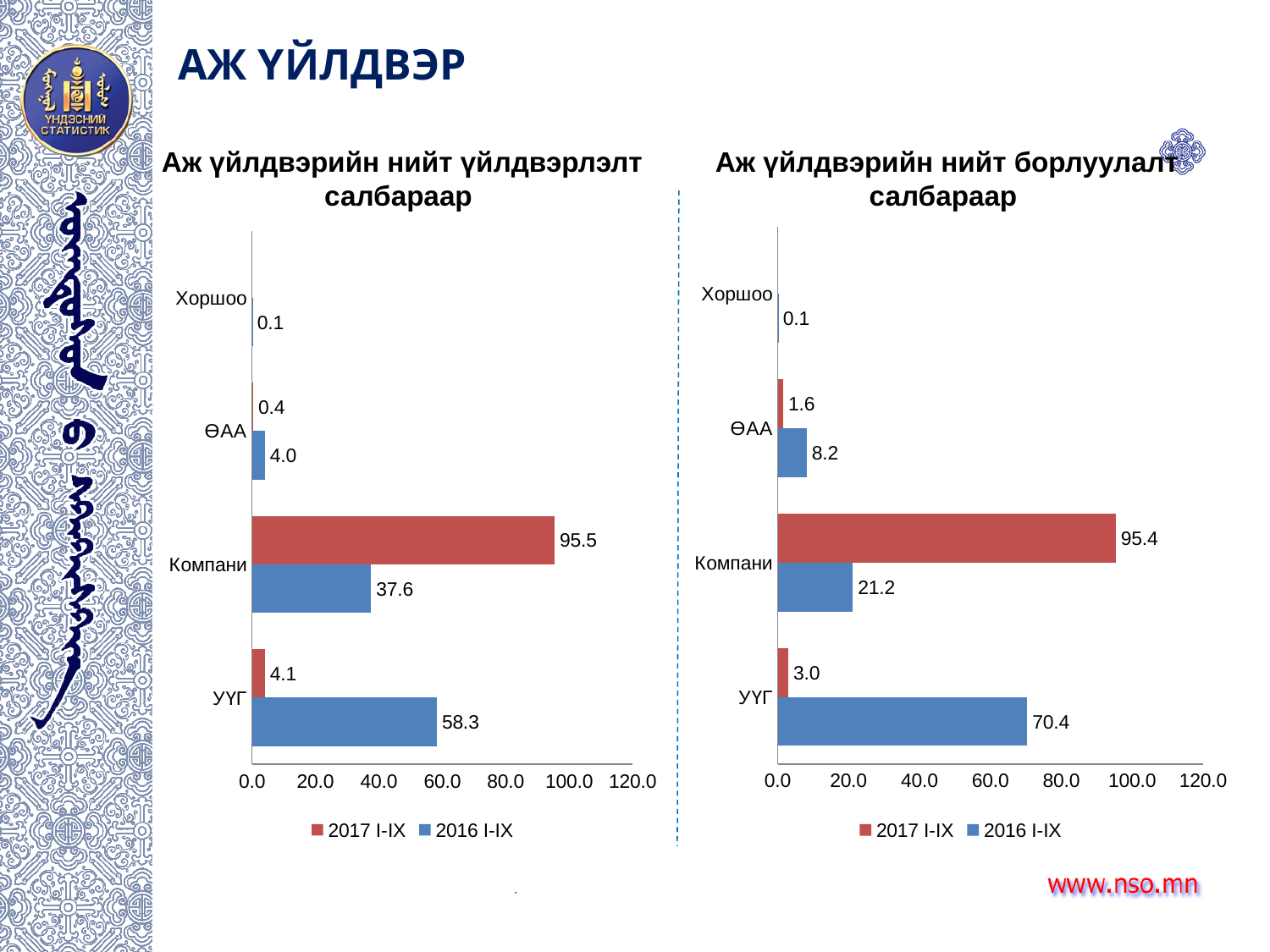
In the left chart (Аж үйлдвэрийн нийт үйлдвэрлэлт салбараар), which category has the highest value for 2016 I-IX? УҮГ How many series does the legend of the left chart (Аж үйлдвэрийн нийт үйлдвэрлэлт салбараар) list? 2 In the right chart (Аж үйлдвэрийн нийт борлуулалт салбараар), what is the value for Компани in 2017 I-IX? 95.4 In the left chart (Аж үйлдвэрийн нийт үйлдвэрлэлт салбараар), what is the value for УҮГ in 2016 I-IX? 58.3 In the right chart (Аж үйлдвэрийн нийт борлуулалт салбараар), which is larger for УҮГ: the 2017 I-IX value or the 2016 I-IX value? 2016 I-IX In the right chart (Аж үйлдвэрийн нийт борлуулалт салбараар), what is the value for ӨАА in 2017 I-IX? 1.6 In the left chart (Аж үйлдвэрийн нийт үйлдвэрлэлт салбараар), what is the value for ӨАА in 2016 I-IX? 4.0 In the left chart (Аж үйлдвэрийн нийт үйлдвэрлэлт салбараар), what is the difference between the 2017 I-IX and 2016 I-IX values for Компани? 57.9 In the right chart (Аж үйлдвэрийн нийт борлуулалт салбараар), what is the difference between the 2016 I-IX and 2017 I-IX values for УҮГ? 67.4 What type of chart is the right chart (Аж үйлдвэрийн нийт борлуулалт салбараар)? Bar chart In the left chart (Аж үйлдвэрийн нийт үйлдвэрлэлт салбараар), what is the value for Компани in 2017 I-IX? 95.5 In the right chart (Аж үйлдвэрийн нийт борлуулалт салбараар), what is the value for УҮГ in 2016 I-IX? 70.4